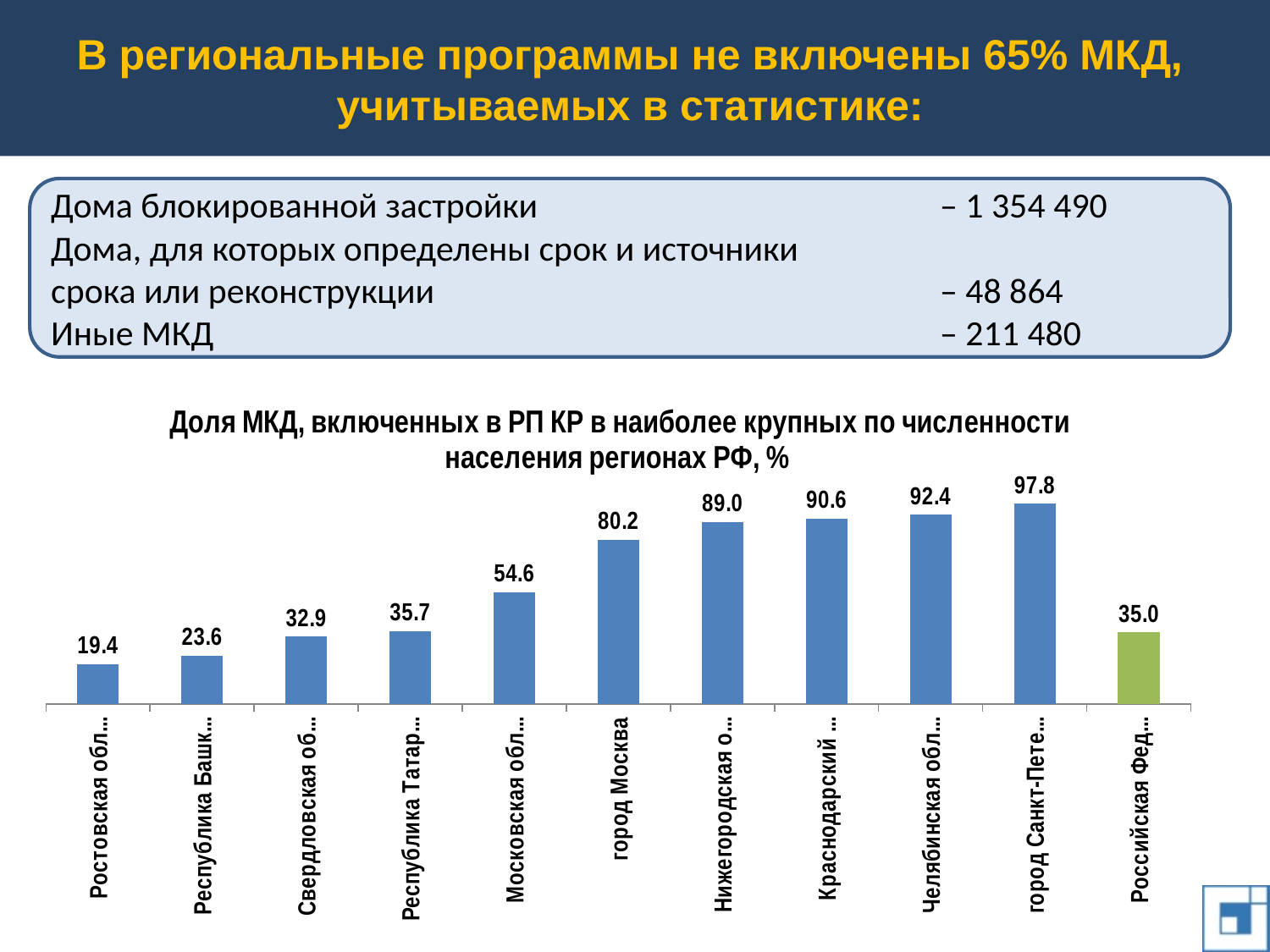
How many bars are plotted in the chart? 11 Which category has the highest value in the chart? город Санкт-Петербург Which category has the lowest value in the chart? Ростовская область Do the values of the blue bars rise or fall from left to right across the chart? Rise What is the difference between the values for Челябинская область and Краснодарский край? 1.8 What kind of chart is shown on the slide? Bar chart What is the value for Ростовская область in the chart? 19.4 What is the value for город Москва in the chart? 80.2 What is the value for Российская Федерация (the green bar) in the chart? 35.0 Which bar in the chart is coloured differently from the others? Российская Федерация (green) What is the difference between the values for город Санкт-Петербург and город Москва? 17.6 Which is larger: the value for Московская область or the value for Республика Татарстан? Московская область